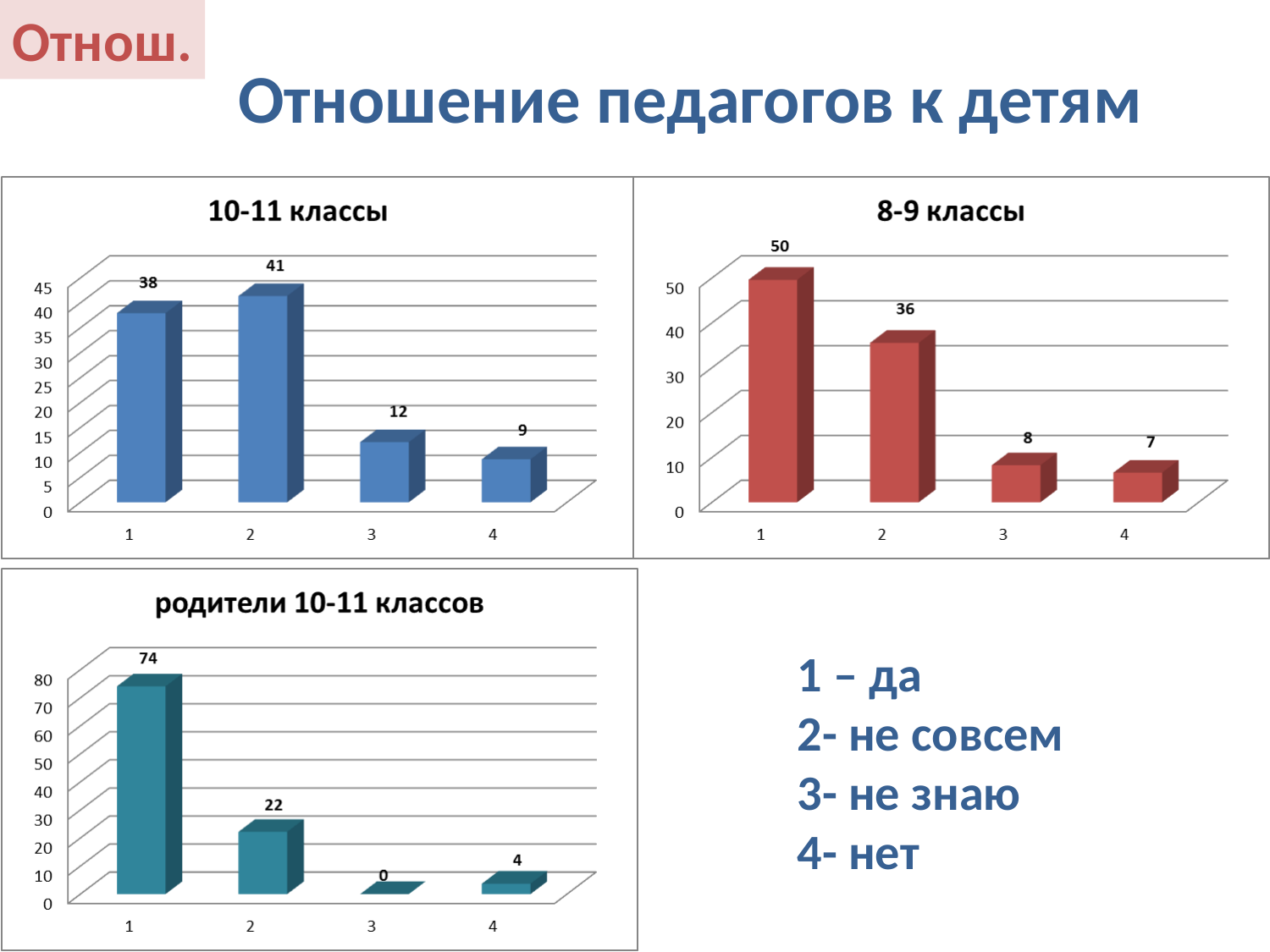
In the "10-11 классы" chart, what is the value for category 2? 41 In the "родители 10-11 классов" chart, is the value for category 1 greater or less than 70? greater In the "8-9 классы" chart, what is the value for category 1? 50 In the "8-9 классы" chart, what is the difference between the values for category 1 and category 2? 14 In the "родители 10-11 классов" chart, what is the value for category 3? 0 In the "8-9 классы" chart, which category has the lowest value? 4 In the "10-11 классы" chart, which category has the highest value? 2 How many categories are shown in the "8-9 классы" chart? 4 How many charts are shown on the slide? 3 What type of chart is the "родители 10-11 классов" chart? bar chart In the "10-11 классы" chart, which is larger: the value for category 3 or category 4? category 3 In the "родители 10-11 классов" chart, what is the difference between the values for category 1 and category 2? 52